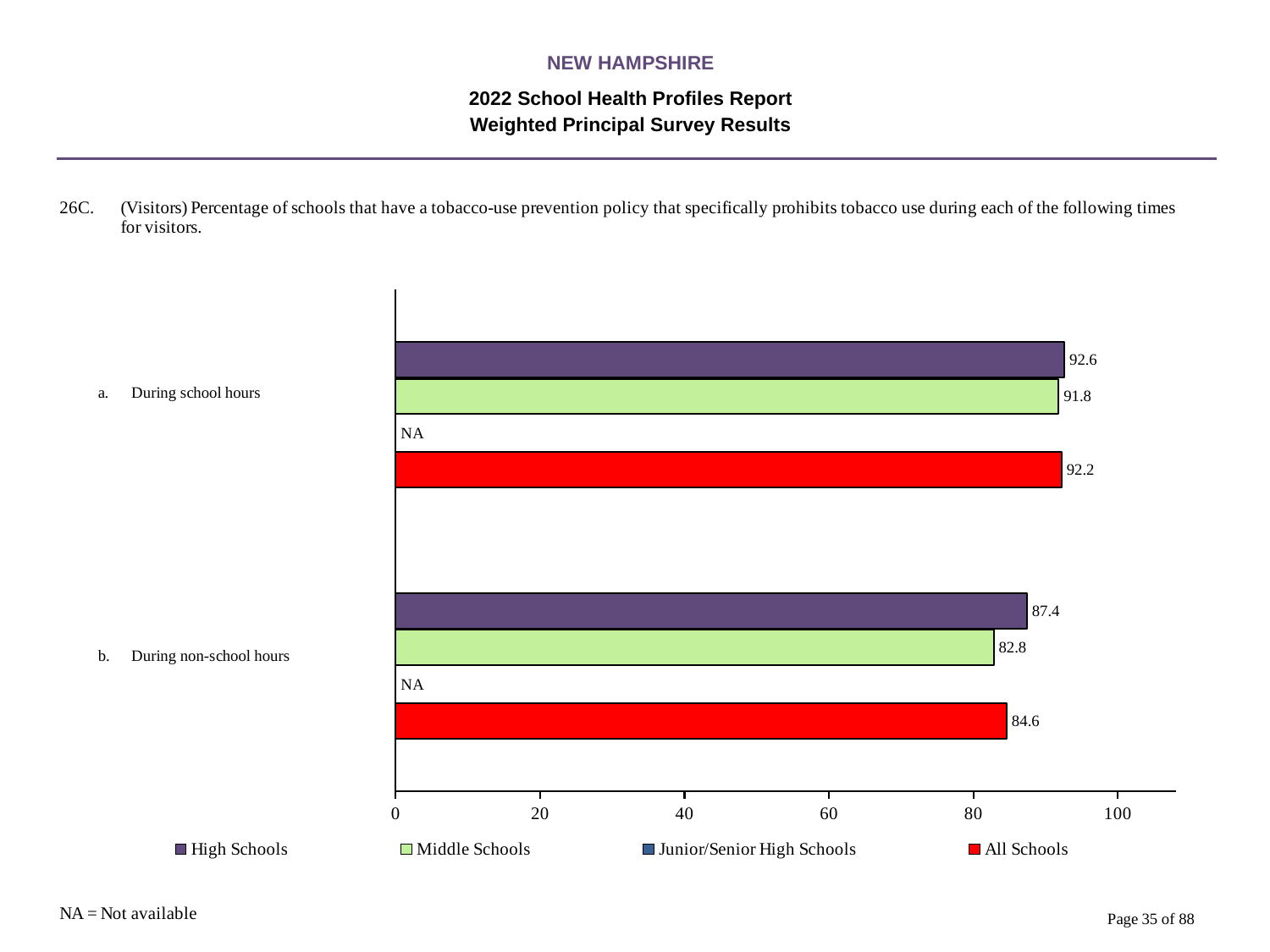
What kind of chart is shown on the slide? Bar chart What is the value for High Schools during school hours? 92.6 What is the difference between the High Schools values for school hours and non-school hours? 5.2 Which series has the lowest value during non-school hours? Middle Schools What is the value for Middle Schools during non-school hours? 82.8 What is the value for All Schools during school hours? 92.2 Which is larger: the All Schools value during school hours or during non-school hours? During school hours How many series does the legend list? 4 What value is shown for Junior/Senior High Schools during non-school hours? NA Is the value for Middle Schools during non-school hours greater or less than 80? greater What colour are the All Schools bars? Red Which series has the highest value during non-school hours? High Schools